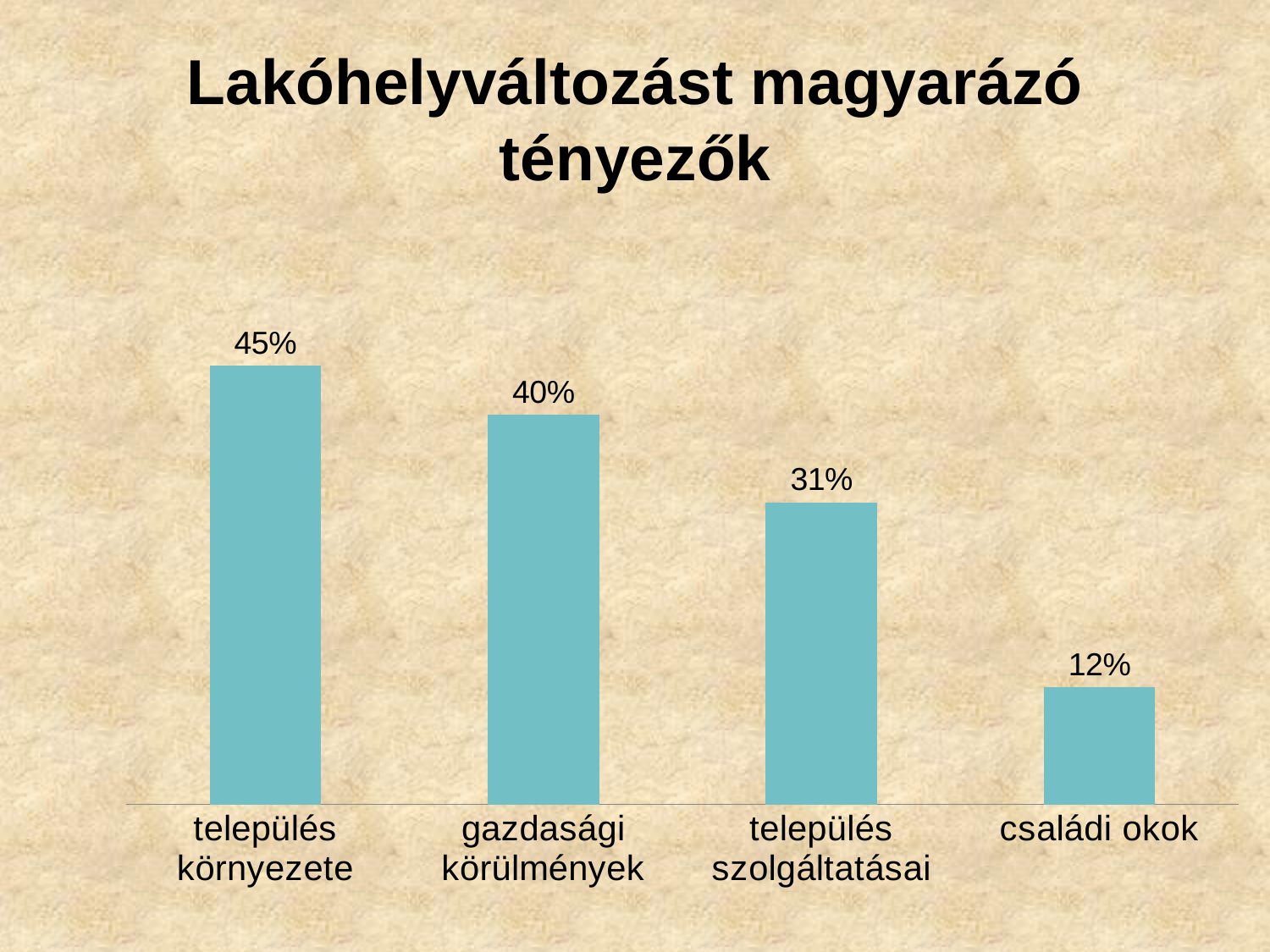
Which is larger, the value for gazdasági körülmények or the value for település szolgáltatásai? gazdasági körülmények What is the value for település környezete? 45% What kind of chart is shown on the slide? bar chart What is the value for település szolgáltatásai? 31% Do the values rise or fall from left to right along the x axis? fall How many categories are shown in the chart? 4 What is the difference between the values for gazdasági körülmények and település szolgáltatásai? 9% What is the value for családi okok? 12% Which category has the highest value? település környezete Which category has the lowest value? családi okok What is the value for gazdasági körülmények? 40% What is the difference between the values for település környezete and családi okok? 33%